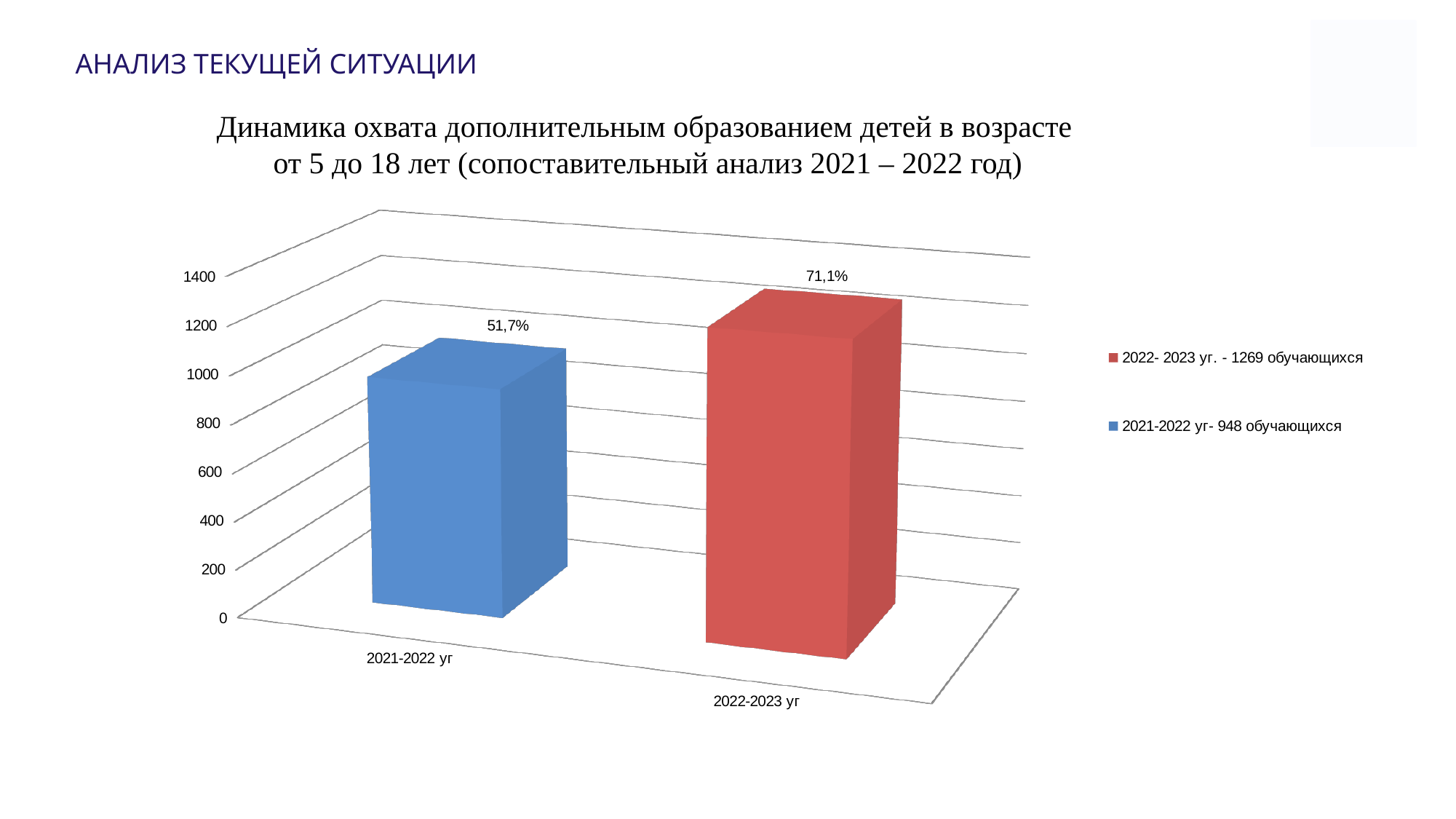
What is the data label shown above the bar for 2022-2023 уг? 71,1% According to the legend, how many обучающихся were there in 2022-2023 уг? 1269 Do the values rise or fall from 2021-2022 уг to 2022-2023 уг? rise What is the difference in the number of обучающихся between 2022-2023 уг and 2021-2022 уг, based on the legend values? 321 What is the data label shown above the bar for 2021-2022 уг? 51,7% What is the difference between the percentage labels for 2022-2023 уг and 2021-2022 уг? 19,4% Is the value for 2021-2022 уг greater or less than 1000? less Which category has the lower bar? 2021-2022 уг How many bars are plotted in the chart? 2 According to the legend, how many обучающихся were there in 2021-2022 уг? 948 Which category has the higher bar? 2022-2023 уг What kind of chart is shown on the slide? bar chart